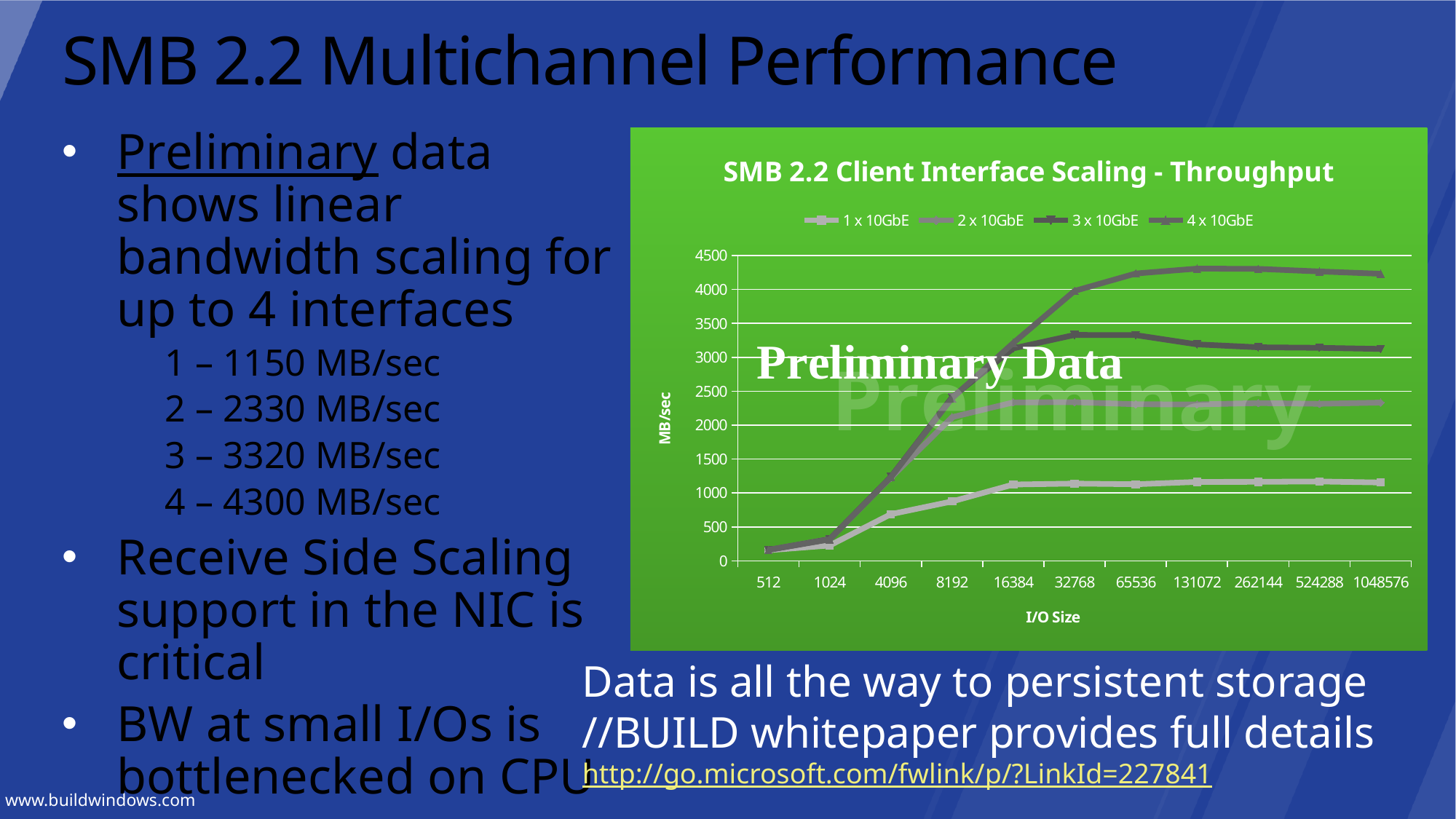
How many series does the chart legend list? 4 Which series has the lowest value at I/O Size 262144? 1 x 10GbE What is the title of the chart? SMB 2.2 Client Interface Scaling - Throughput At I/O Size 32768, which series has the larger value, 4 x 10GbE or 1 x 10GbE? 4 x 10GbE Is the value for 4 x 10GbE at I/O Size 8192 greater or less than 3000? less Is the value for 2 x 10GbE at I/O Size 512 greater or less than 500? less Which series has the highest value at I/O Size 1048576? 4 x 10GbE Is the value for 3 x 10GbE at I/O Size 65536 greater or less than 3000? greater How many I/O Size categories are shown on the x axis? 11 What is the label of the y axis? MB/sec What kind of chart is shown on the slide? line chart